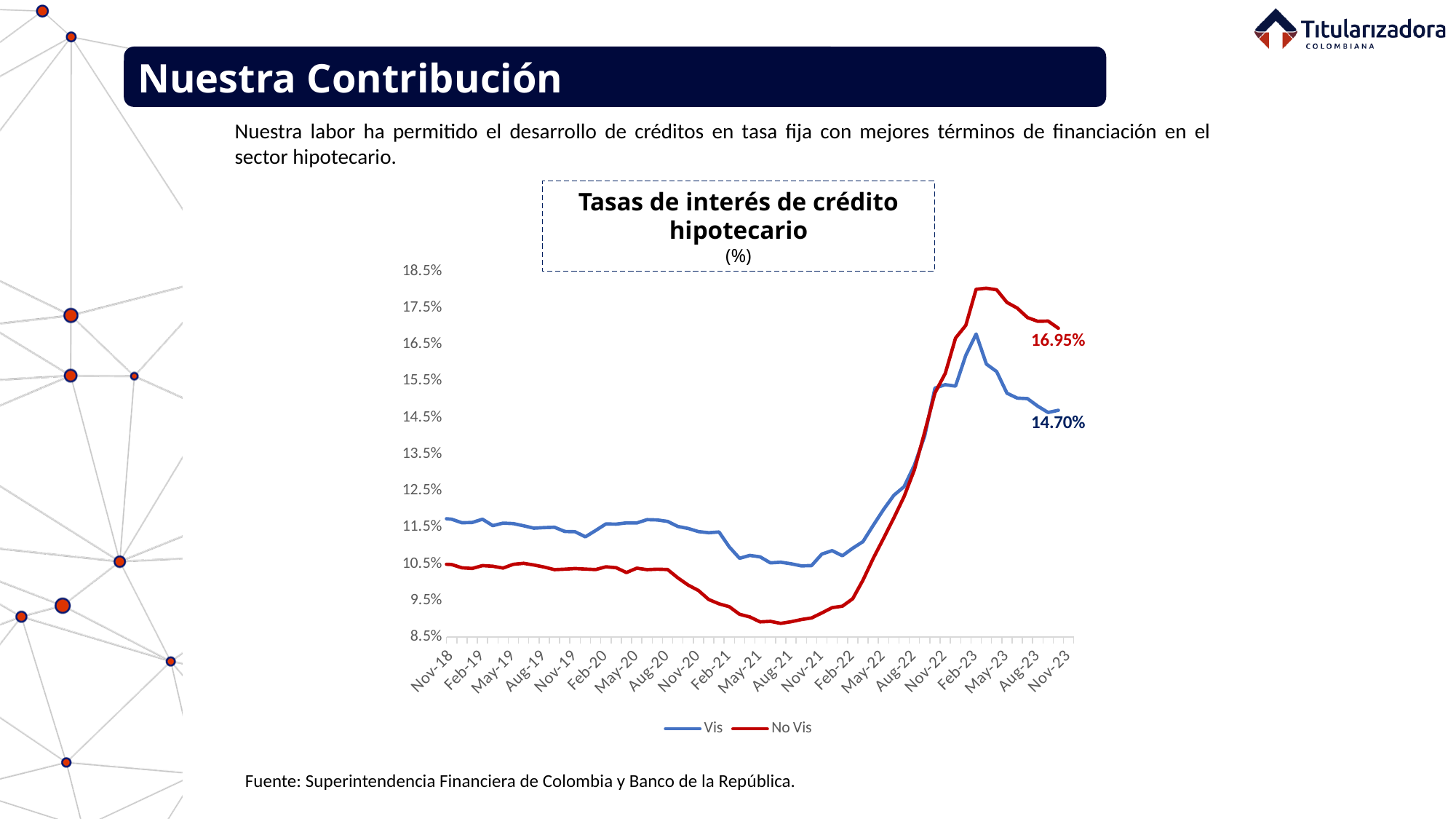
Is the value for Vis at Feb-23 greater or less than 15.5%? greater What colour is the Vis series line? Blue At Nov-23, which series has the higher value, Vis or No Vis? No Vis How many series does the legend list? 2 What is the value of the Vis series at Nov-23? 14.70% Is the value for No Vis at Nov-18 greater or less than 11.5%? less What kind of chart is shown on the slide? Line chart What is the difference between the No Vis and Vis values at Nov-23? 2.25 percentage points What is the value of the No Vis series at Nov-23? 16.95% Is the value for No Vis at Aug-21 greater or less than 9.5%? less Which series reaches the highest value on the chart? No Vis Does the No Vis series rise or fall between Feb-23 and Nov-23? Fall